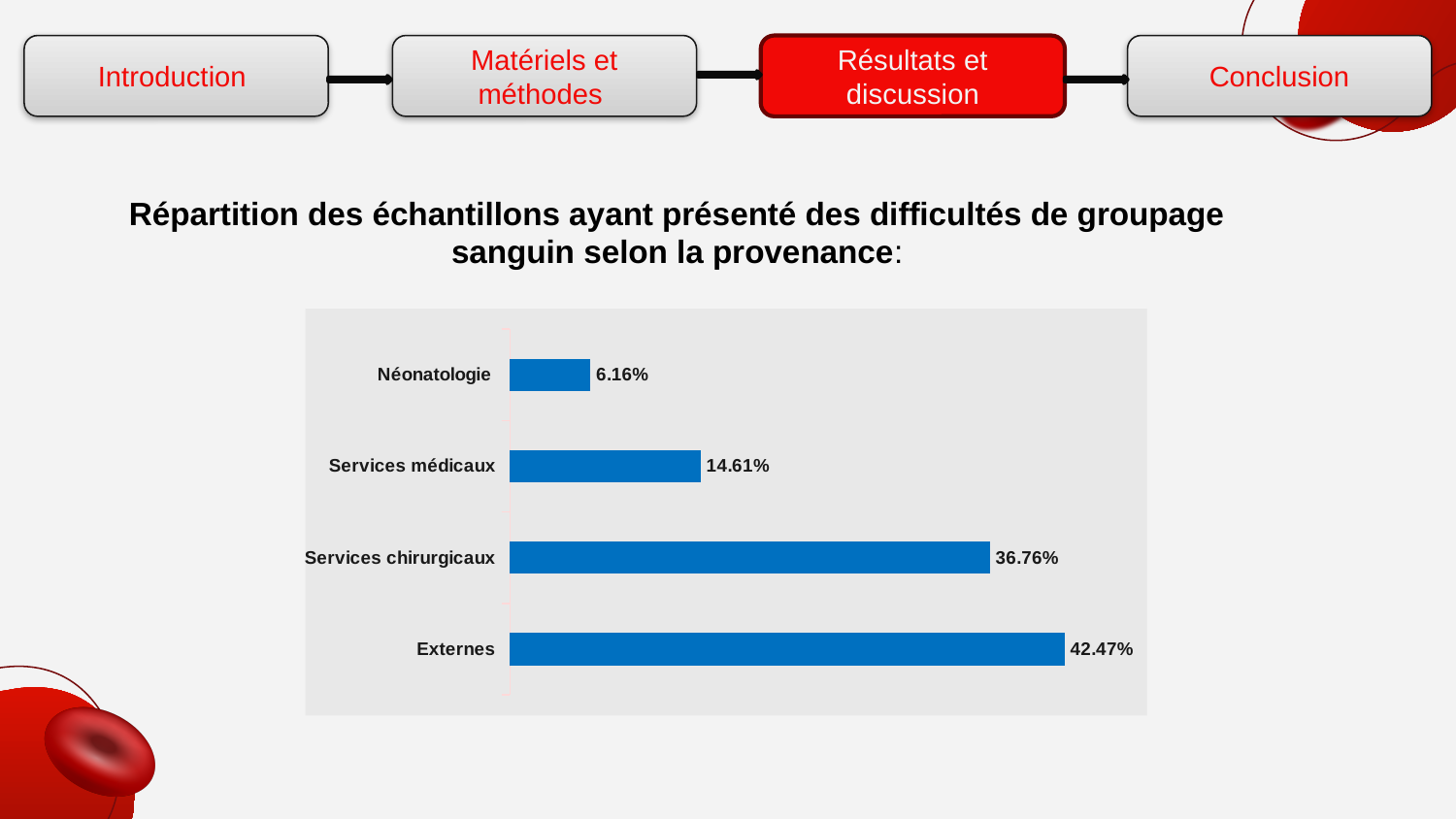
What is the difference between the values for Externes and Services chirurgicaux? 5.71% What is the value for Externes? 42.47% What is the title of the chart on the slide? Répartition des échantillons ayant présenté des difficultés de groupage sanguin selon la provenance How many categories are shown in the chart? 4 What is the value for Néonatologie? 6.16% What kind of chart is shown on the slide? Bar chart Which category has the highest value? Externes What is the value for Services chirurgicaux? 36.76% Which is larger, the value for Services médicaux or the value for Services chirurgicaux? Services chirurgicaux Which category has the lowest value? Néonatologie What is the value for Services médicaux? 14.61% What is the difference between the values for Services médicaux and Néonatologie? 8.45%